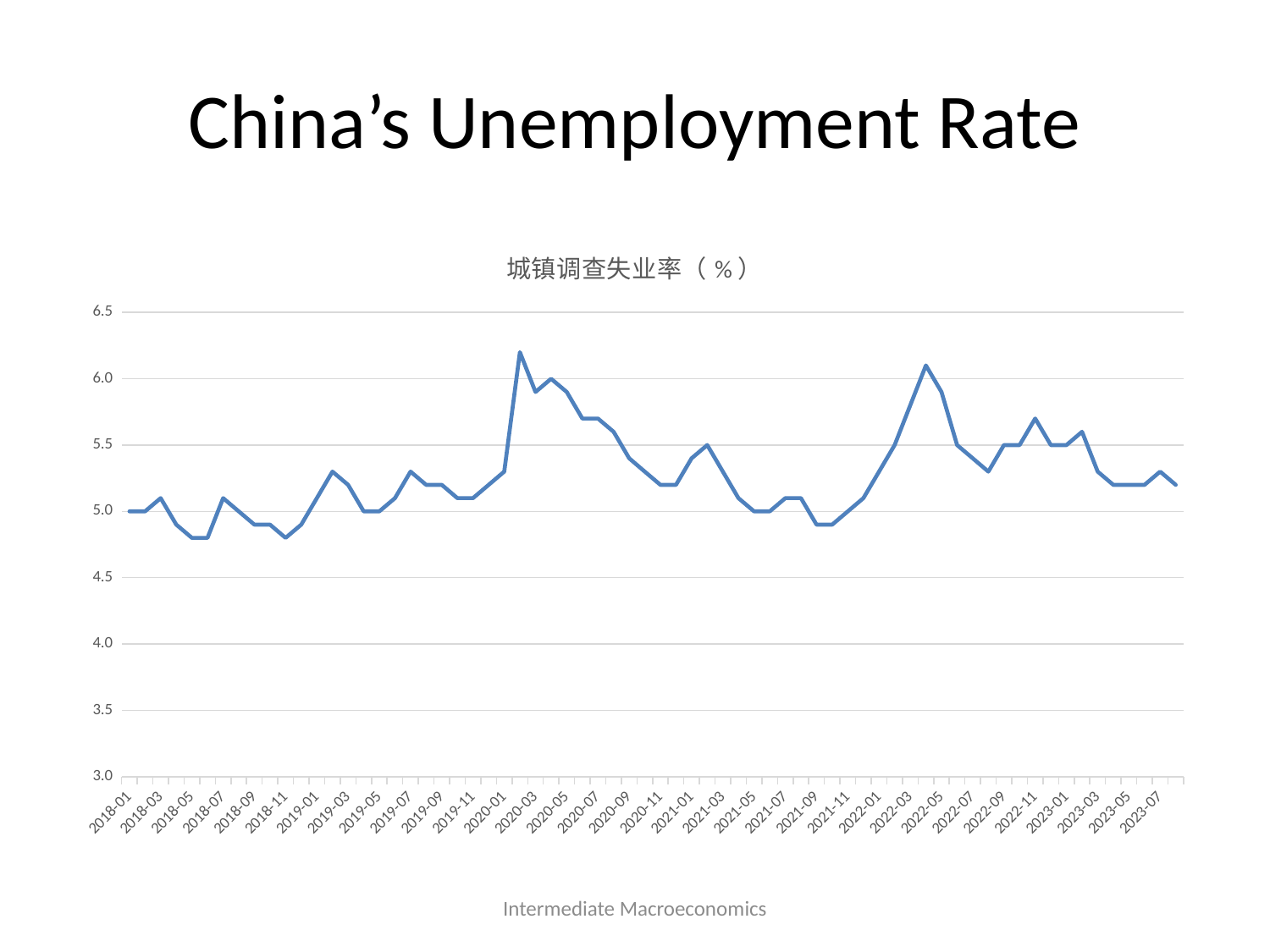
Is the value for 2021-10 greater or less than 5.0? less Is the value for 2018-06 greater or less than 5.0? less Is the value for 2020-02 greater or less than 6.0? greater Which month has the highest unemployment rate on the chart? 2020-02 What kind of chart is shown on the slide? line chart What is the title of the slide? China's Unemployment Rate Does the unemployment rate rise or fall from 2022-04 to 2022-07? fall Which is larger, the value for 2020-03 or the value for 2021-03? 2020-03 What is the chart's own title printed above the plot area? 城镇调查失业率（%）